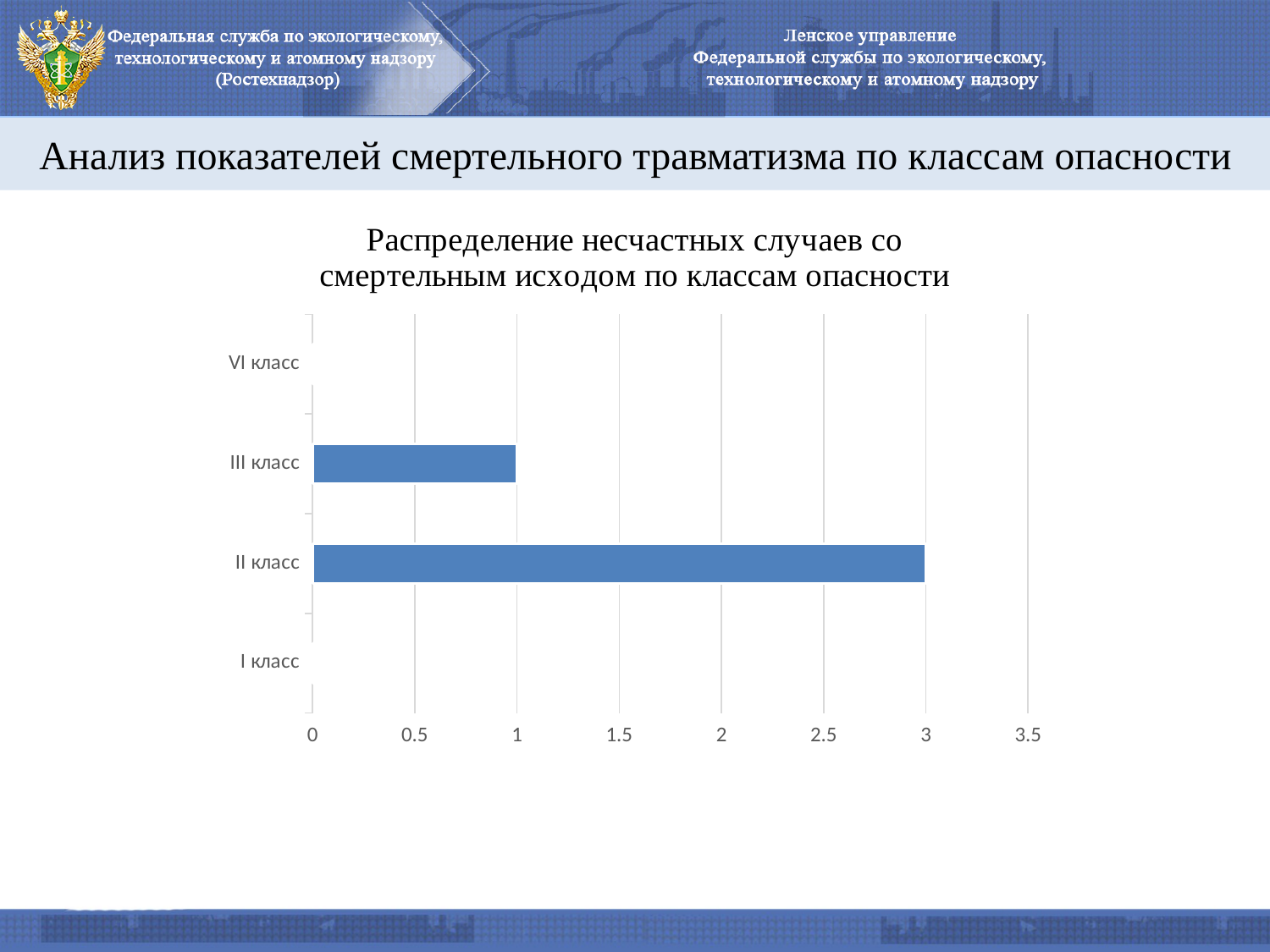
What is the value for II класс in the chart? 3 Is the value for II класс greater or less than 2? greater Is the value for I класс greater or less than 0.5? less What is the difference between the values for II класс and III класс? 2 What is the value for III класс in the chart? 1 Which hazard class has the highest value in the chart? II класс What is the title of the chart? Распределение несчастных случаев со смертельным исходом по классам опасности What kind of chart is shown on the slide? bar chart Which has a larger value, II класс or III класс? II класс How many hazard classes (categories) are listed on the vertical axis of the chart? 4 Is the value for III класс greater or less than 2? less What colour are the bars in the chart? blue